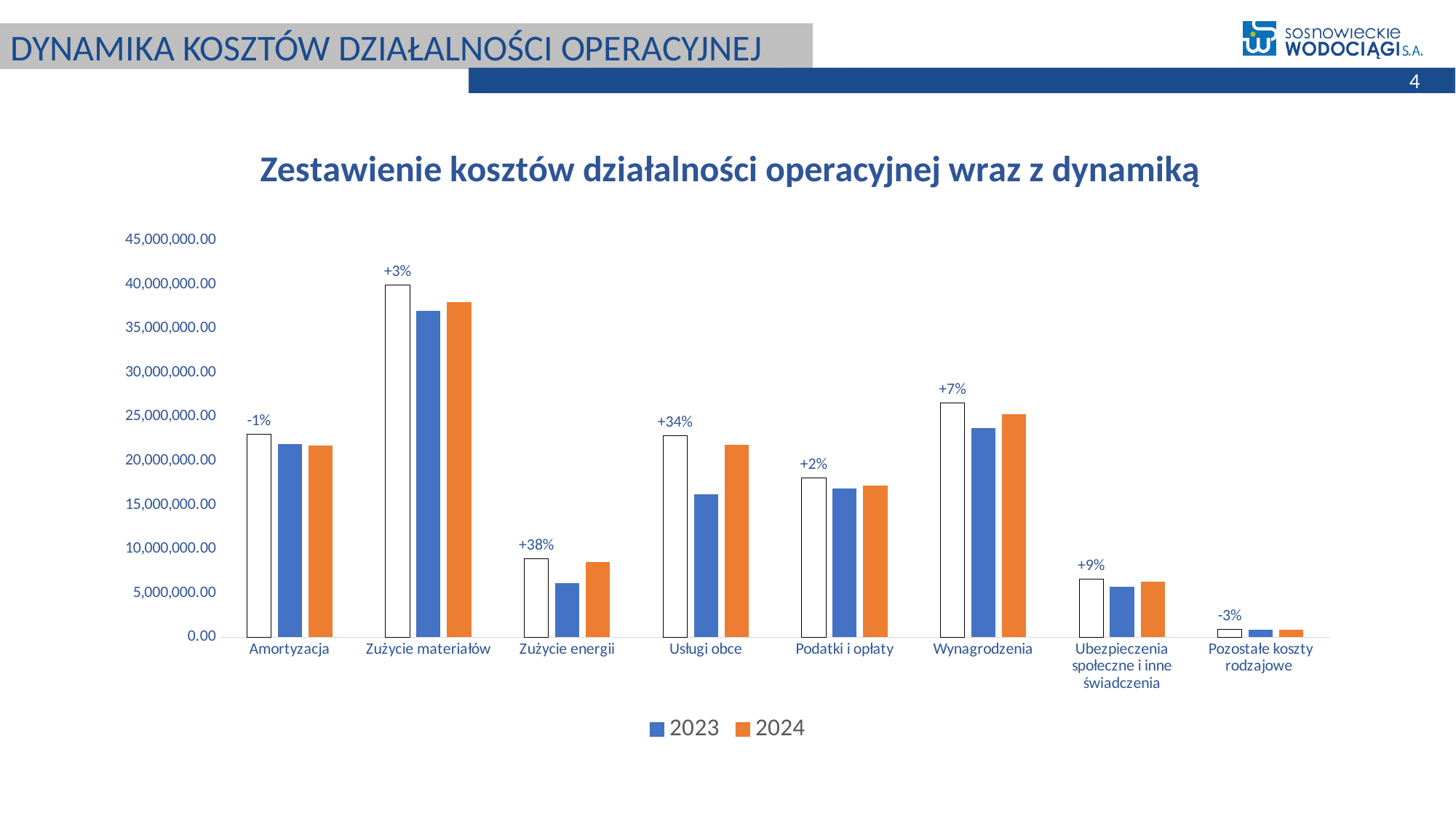
What percentage change is labelled above the Zużycie energii group? +38% Which category has the lowest 2023 value? Pozostałe koszty rodzajowe Is the 2023 value for Zużycie energii greater or less than 10,000,000.00? less What kind of chart is shown on the slide? bar chart What percentage change is labelled above the Pozostałe koszty rodzajowe group? -3% What percentage change is labelled above the Usługi obce group? +34% Which category has the highest 2024 value? Zużycie materiałów What is the title of the chart? Zestawienie kosztów działalności operacyjnej wraz z dynamiką How many categories are shown on the x axis? 8 Is the 2023 value for Zużycie materiałów greater or less than 35,000,000.00? greater For Usługi obce, which is larger: the 2023 value or the 2024 value? 2024 How many series does the legend list? 2